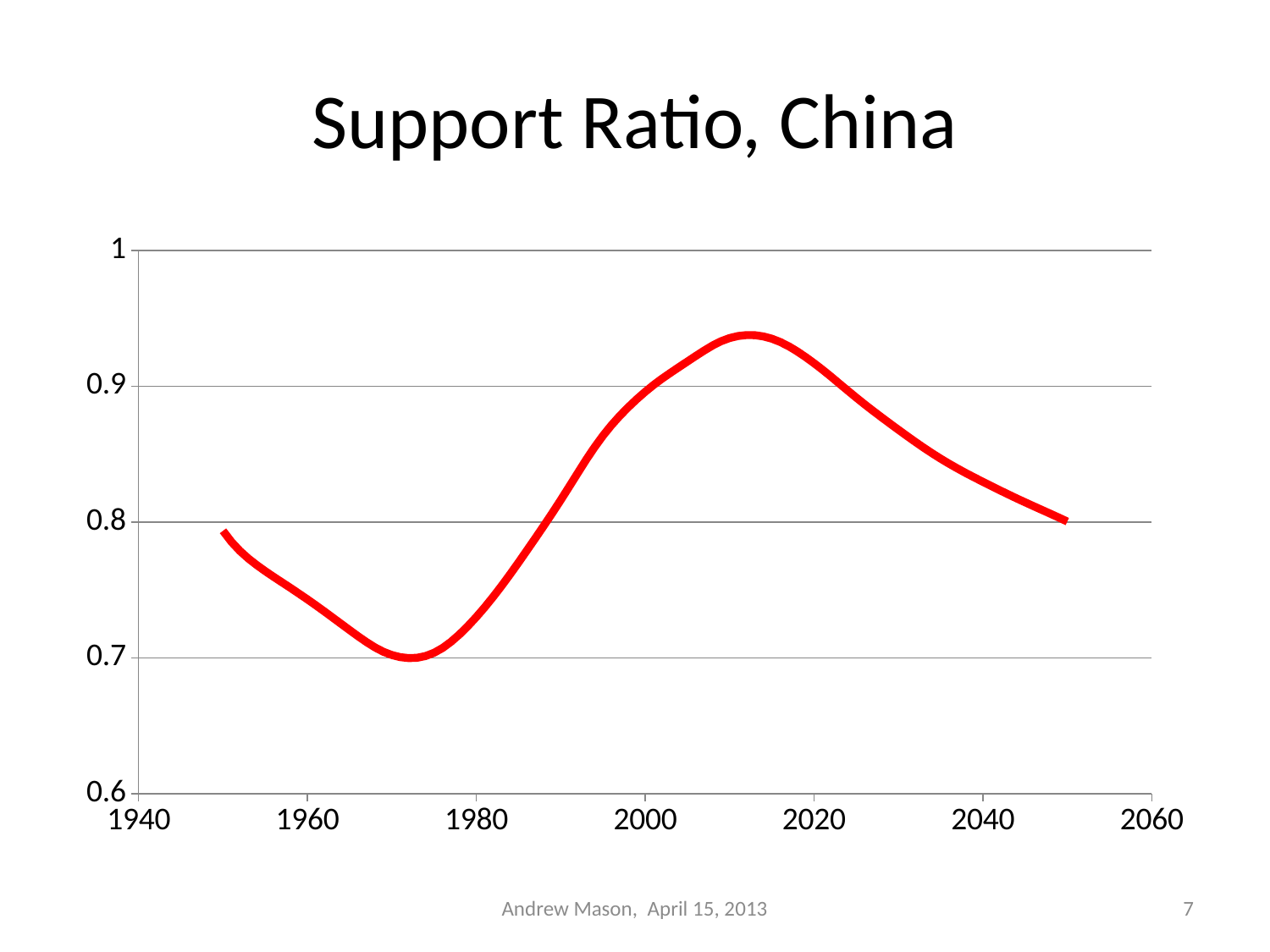
Is the support ratio for China in 1980 greater or less than 0.8? less What kind of chart is shown on the slide? line chart Does the support ratio for China rise or fall between 2020 and 2050? fall What is the title of the chart? Support Ratio, China Is the support ratio for China in 2030 greater or less than 0.9? less Is the support ratio for China in 1990 greater or less than 0.8? greater Which is larger, the support ratio for China in 1970 or in 2000? 2000 Does the support ratio for China rise or fall between 1980 and 2010? rise